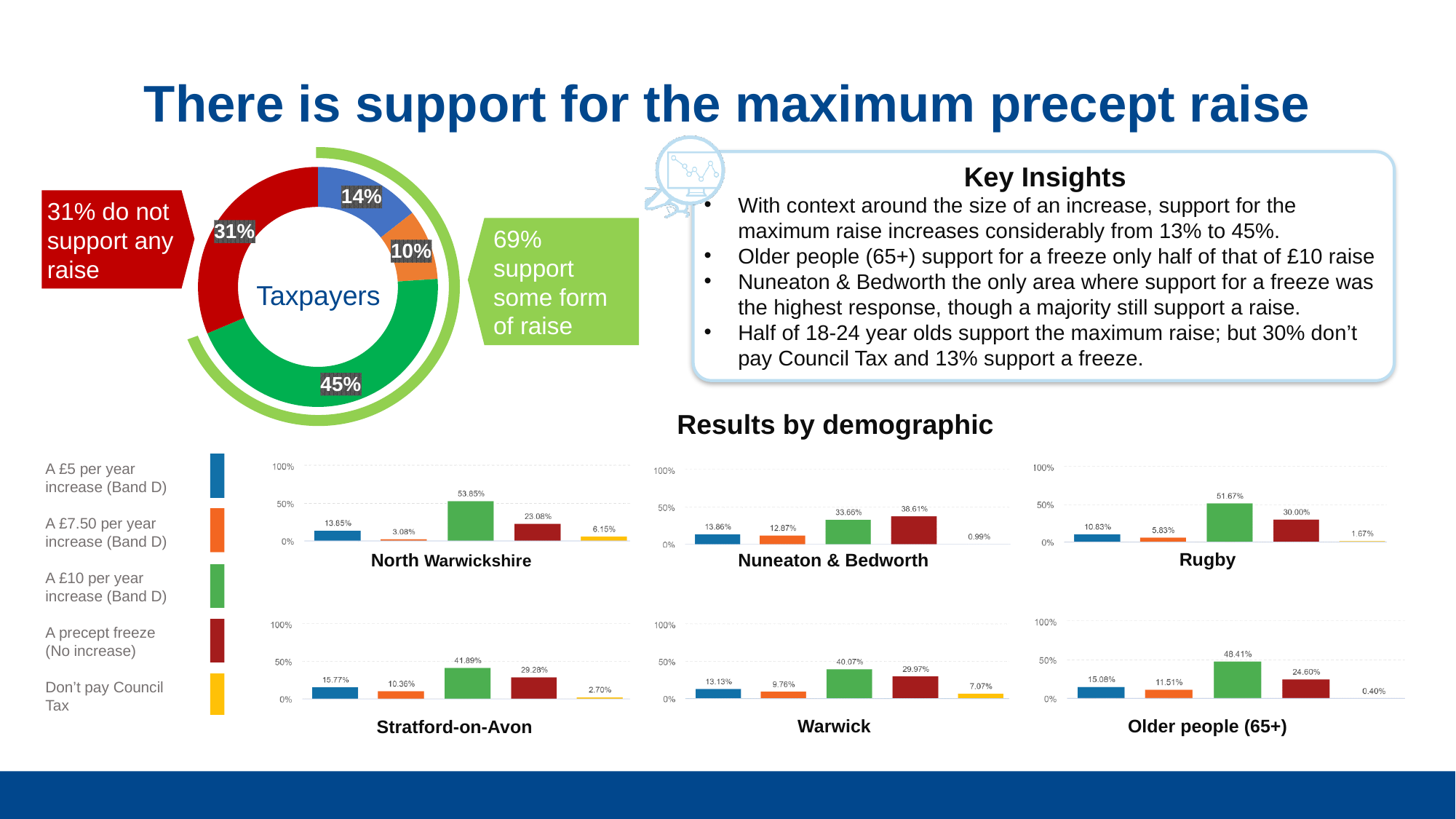
How many entries does the shared legend for the Results by demographic bar charts list? 5 How many bars are plotted in the Rugby bar chart? 5 What kind of chart is the Taxpayers chart at the top left of the slide? Donut chart In the Nuneaton & Bedworth bar chart, which option has the highest value? A precept freeze (No increase) In the Older people (65+) bar chart, is the value for the £10 per year increase greater or less than 50%? less In the Stratford-on-Avon bar chart, which option has the lowest value? Don't pay Council Tax In the Nuneaton & Bedworth bar chart, which is larger: the £5 per year increase value or the £7.50 per year increase value? £5 per year increase In the Taxpayers donut chart, what share of the donut is the largest slice? 45% In the Warwick bar chart, what is the difference between the £10 per year increase value and the precept freeze value? 10.10% In the Taxpayers donut chart, what percentage is shown for the red slice? 31% In the North Warwickshire bar chart, what is the value for the £10 per year increase (green bar)? 53.85% In the Rugby bar chart, what is the value for the precept freeze (red bar)? 30.00%